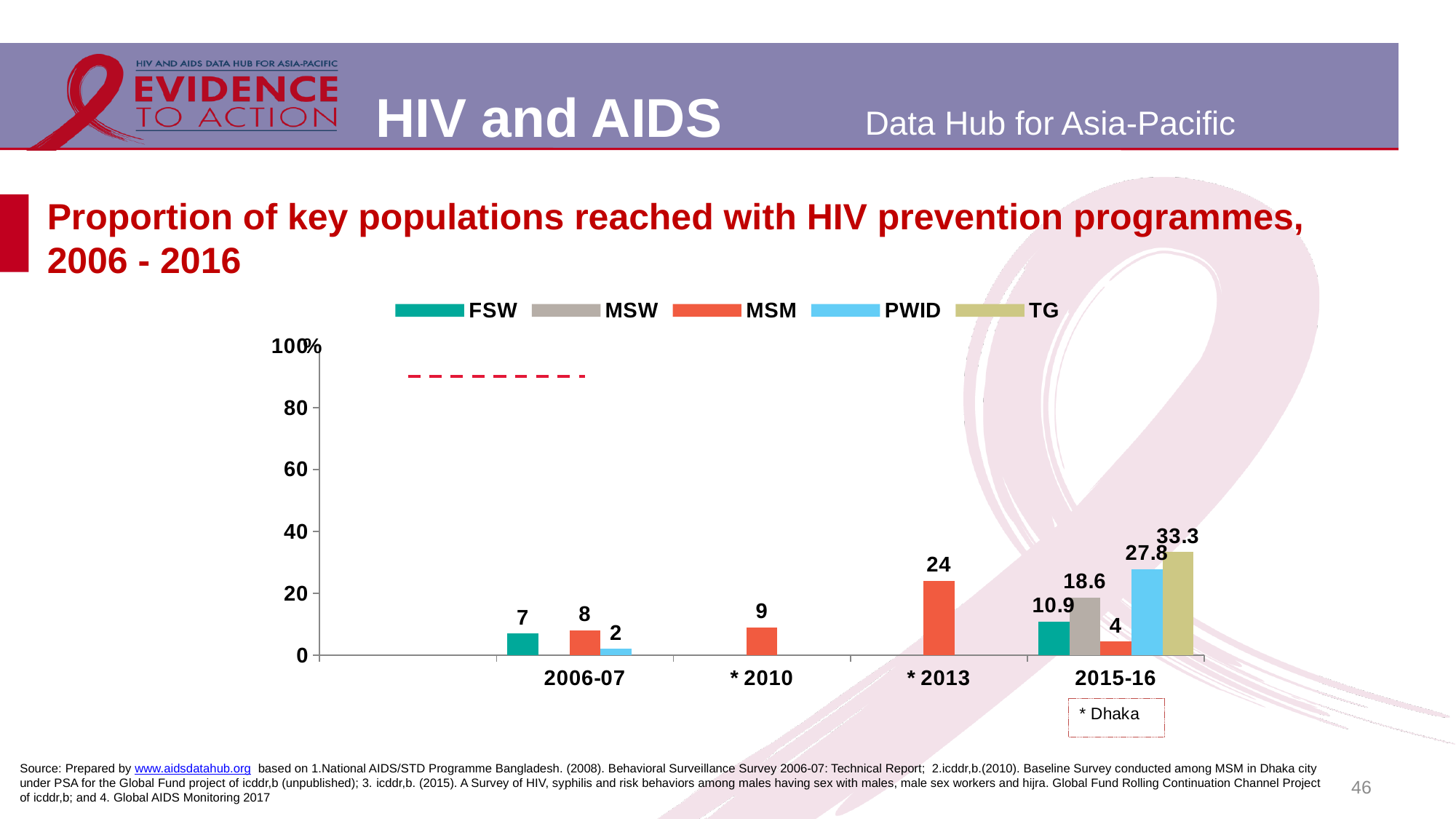
What is the value for MSM in * 2013? 24 What is the difference between the PWID value and the FSW value in 2015-16? 16.9 What type of chart is shown on the slide? bar chart Which key population has the lowest value in 2015-16? MSM Which is larger, the MSM value in * 2010 or the MSM value in * 2013? * 2013 Which key population has the highest value in 2015-16? TG How many series does the legend list? 5 Does the MSM value rise or fall from 2006-07 to * 2013? rise What is the value for TG in 2015-16? 33.3 What is the value for MSW in 2015-16? 18.6 How many year categories are shown on the x axis? 4 What is the value for PWID in 2006-07? 2